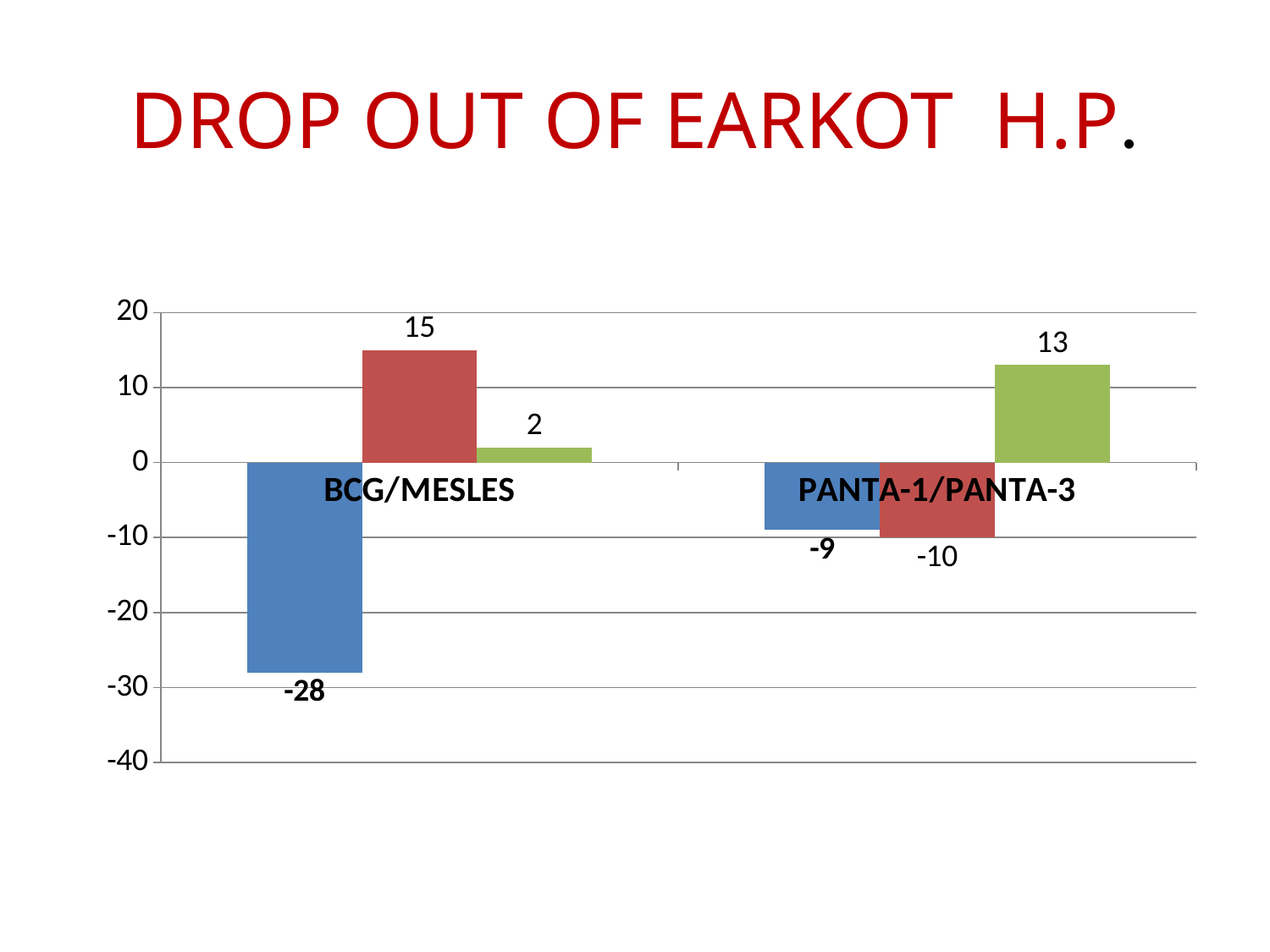
Which bar has the lowest value on the chart? The blue bar for BCG/MESLES (-28) What is the difference between the red bar (15) and the green bar (2) for BCG/MESLES? 13 What is the value of the red bar for PANTA-1/PANTA-3? -10 What is the title of the slide? DROP OUT OF EARKOT H.P. What is the value of the green bar for PANTA-1/PANTA-3? 13 What type of chart is shown on the slide? Bar chart What is the value of the blue bar for BCG/MESLES? -28 What is the value of the red bar for BCG/MESLES? 15 Which bar has the highest value on the chart? The red bar for BCG/MESLES (15) How many categories are shown on the x axis? 2 Is the value of the blue bar for BCG/MESLES greater or less than -20? less Which is larger: the green bar for BCG/MESLES or the green bar for PANTA-1/PANTA-3? The green bar for PANTA-1/PANTA-3